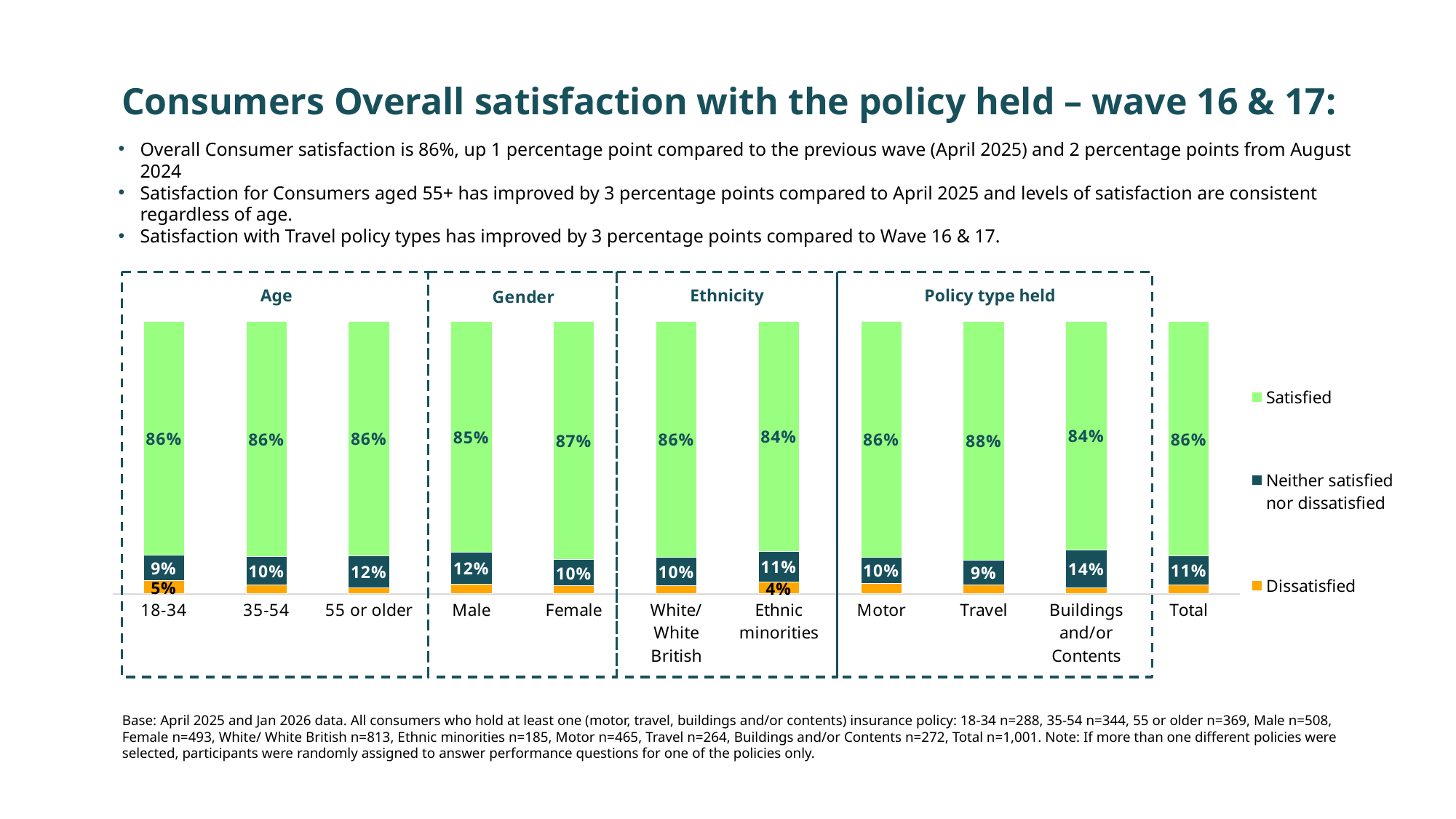
Which colour represents the Dissatisfied series in the legend? Orange Which category has the highest 'Neither satisfied nor dissatisfied' percentage? Buildings and/or Contents How many series does the legend list? 3 What is the Satisfied value for the Total bar? 86% How many categories (bars) are shown on the chart? 11 What kind of chart is shown on the slide? Stacked bar chart What percentage of consumers aged 18-34 are dissatisfied? 5% Which has a higher Satisfied percentage, Travel or Buildings and/or Contents? Travel What percentage of consumers aged 18-34 are satisfied with the policy held? 86% What is the difference between the Satisfied percentage for Female and for Male? 2 percentage points Which category has the highest Satisfied percentage? Travel What is the 'Neither satisfied nor dissatisfied' value for Buildings and/or Contents? 14%